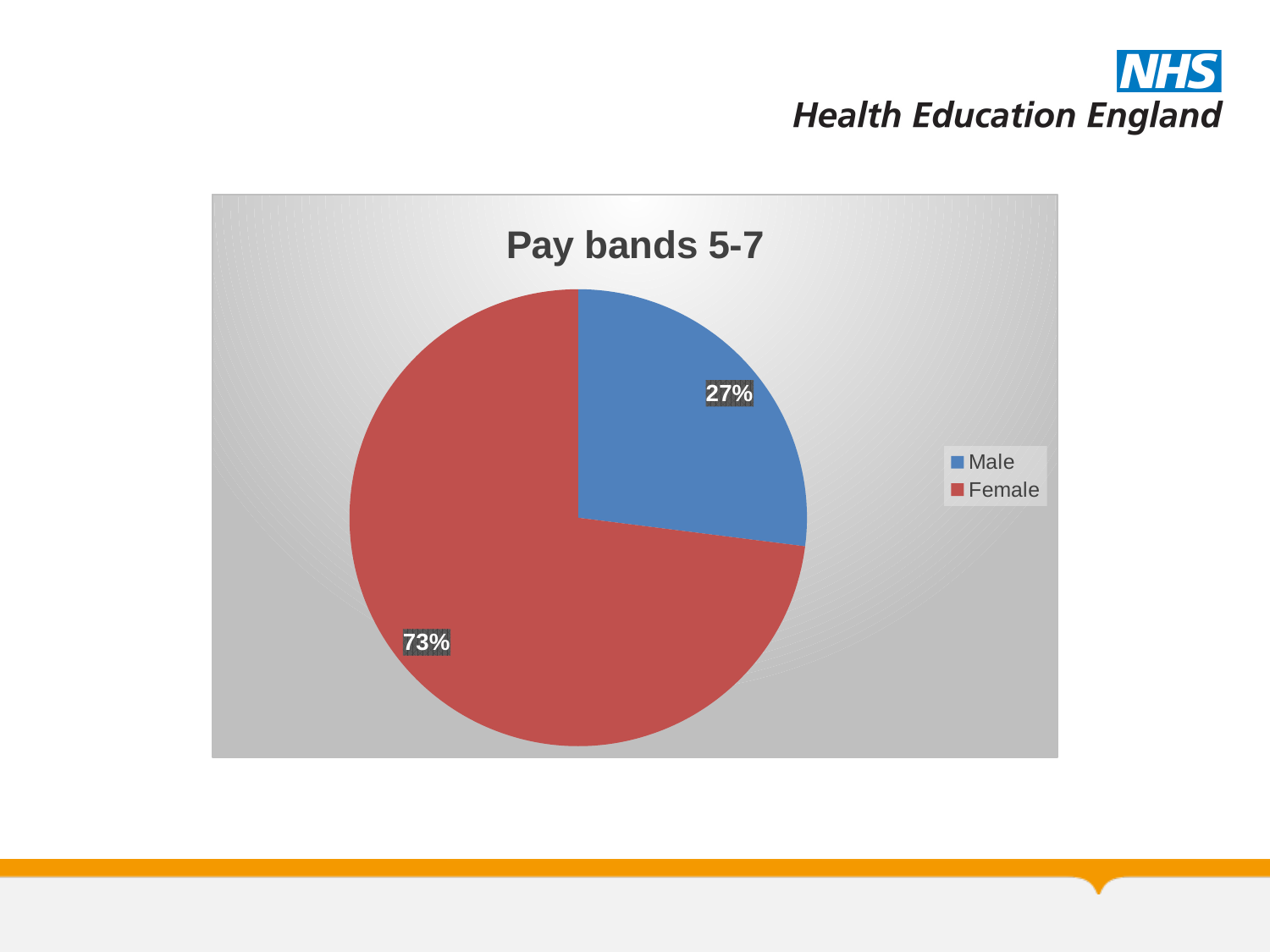
Which category has the smallest share of the pie? Male How many entries does the legend list? 2 What is the difference in percentage points between the Female and Male shares? 46 How many slices does the pie chart have? 2 What percentage of the pie is Male? 27% What is the title of the chart? Pay bands 5-7 Which is larger, the Male share or the Female share? Female What share of the pie does the Male slice represent? 27% What type of chart is shown on the slide? Pie chart What percentage of the pie is Female? 73% Which category has the largest share of the pie? Female What colour is the Female slice? Red